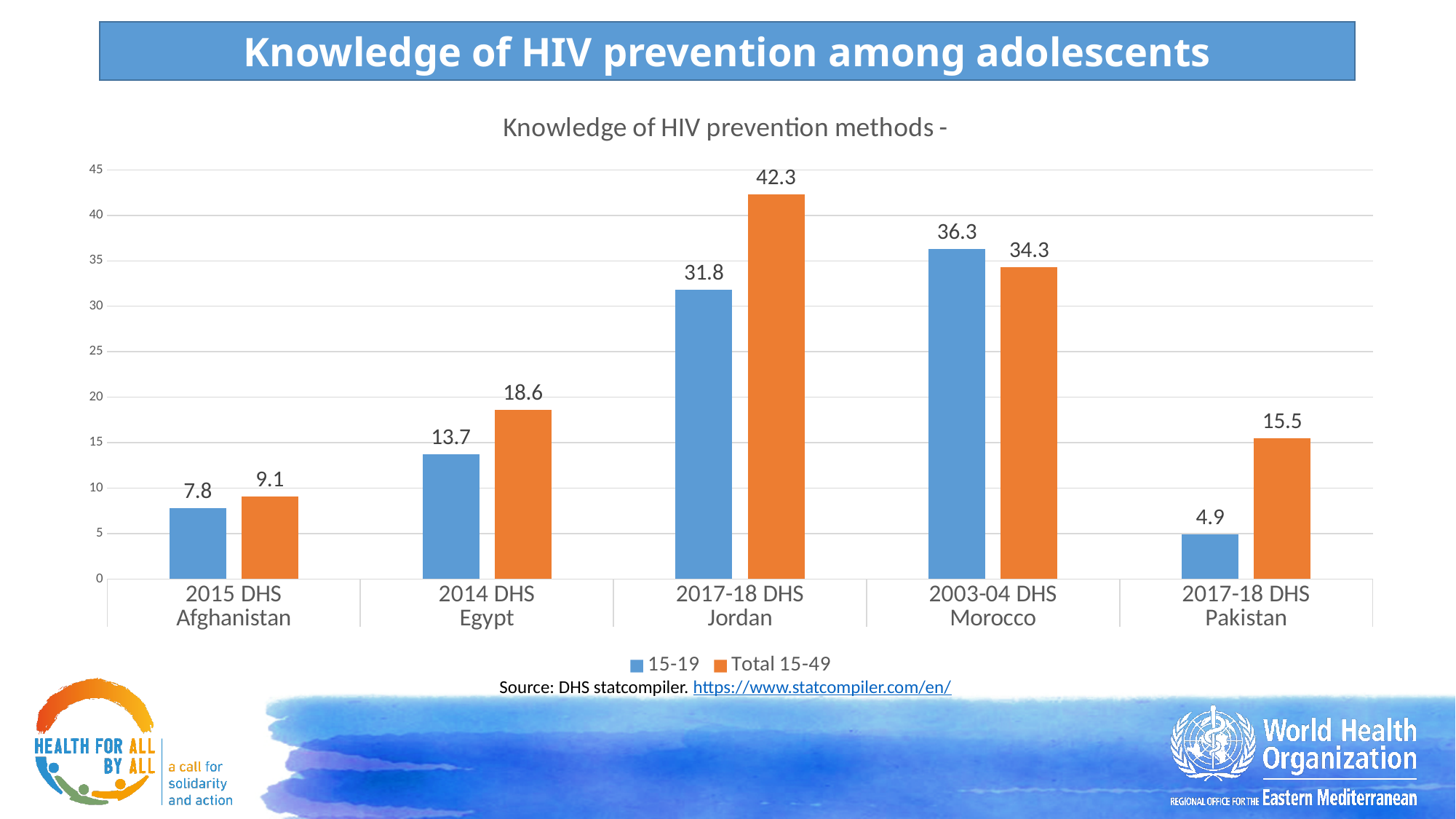
Is the Total 15-49 value for 2014 DHS Egypt greater or less than 20? less Which category has the lowest 15-19 value? 2017-18 DHS Pakistan Which is larger for 2003-04 DHS Morocco: the 15-19 value or the Total 15-49 value? 15-19 What is the value for the Total 15-49 series for 2015 DHS Afghanistan? 9.1 How many categories are shown on the x axis? 5 Which colour represents the Total 15-49 series? orange What is the value for the 15-19 series for 2017-18 DHS Pakistan? 4.9 What is the value for the 15-19 series for 2017-18 DHS Jordan? 31.8 Which category has the highest Total 15-49 value? 2017-18 DHS Jordan How many series does the legend list? 2 What is the difference between the Total 15-49 and 15-19 values for 2017-18 DHS Pakistan? 10.6 What kind of chart is shown on the slide? bar chart